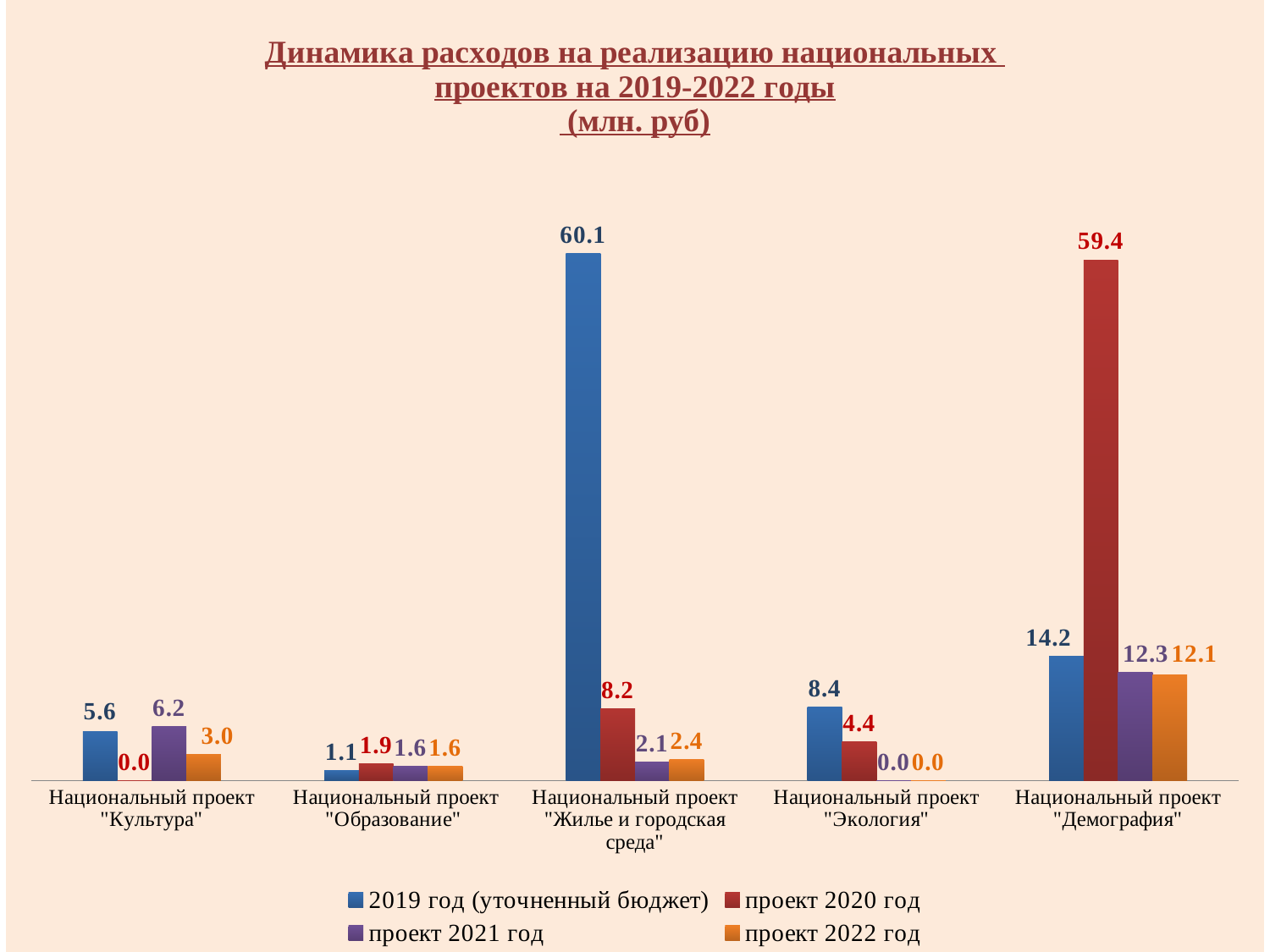
Which category has the highest value in the проект 2020 год series? Национальный проект "Демография" What kind of chart is shown on the slide? Bar chart How many series does the legend list? 4 Which category has the lowest value in the 2019 год (уточненный бюджет) series? Национальный проект "Образование" What is the value for the проект 2022 год series for Национальный проект "Культура"? 3.0 What is the total of the four series values for Национальный проект "Демография"? 98.0 What is the value for the 2019 год (уточненный бюджет) series for Национальный проект "Жилье и городская среда"? 60.1 What is the value for the проект 2020 год series for Национальный проект "Демография"? 59.4 What is the difference between the 2019 год (уточненный бюджет) value and the проект 2020 год value for Национальный проект "Жилье и городская среда"? 51.9 How many categories are shown on the x axis? 5 Which is larger for Национальный проект "Экология": the 2019 год (уточненный бюджет) value or the проект 2020 год value? 2019 год (уточненный бюджет) What is the value for the проект 2021 год series for Национальный проект "Образование"? 1.6